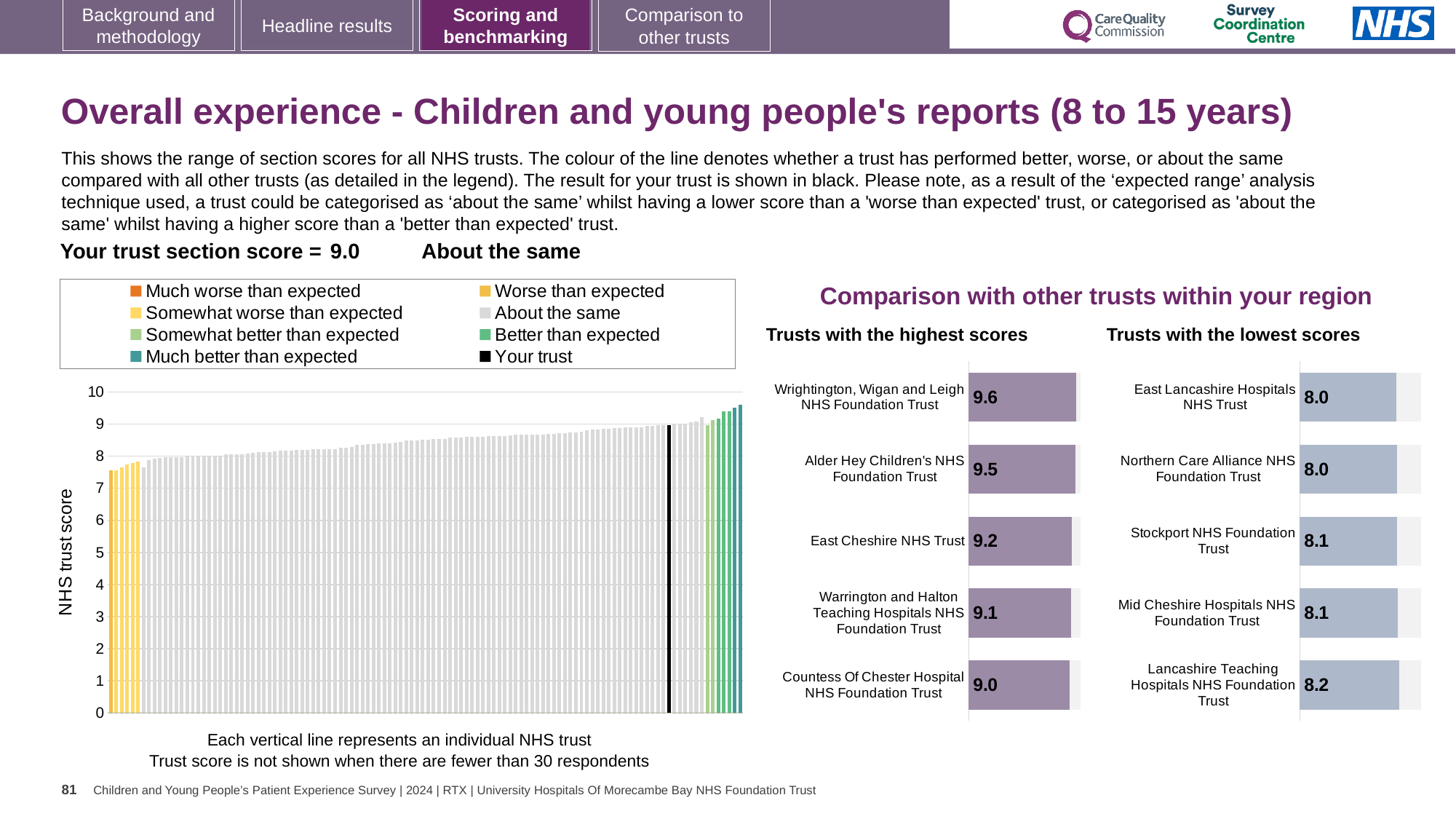
In the 'Trusts with the lowest scores' chart, what is the difference between the score for Lancashire Teaching Hospitals NHS Foundation Trust and the score for East Lancashire Hospitals NHS Trust? 0.2 In the 'Trusts with the lowest scores' chart, which has the larger score: Stockport NHS Foundation Trust or Northern Care Alliance NHS Foundation Trust? Stockport NHS Foundation Trust In the 'Trusts with the highest scores' chart, which trust has the lowest score? Countess Of Chester Hospital NHS Foundation Trust What kind of chart is the main chart on the left showing all NHS trusts? Bar chart How many trusts are listed in the 'Trusts with the highest scores' chart? 5 In the main chart on the left, is the value for the lowest-scoring trust (the leftmost bar) greater or less than 8? less In the 'Trusts with the highest scores' chart, what is the difference between the scores of Wrightington, Wigan and Leigh NHS Foundation Trust and Alder Hey Children's NHS Foundation Trust? 0.1 In the 'Trusts with the highest scores' chart, what is the score for East Cheshire NHS Trust? 9.2 In the 'Trusts with the highest scores' chart, which trust has the highest score? Wrightington, Wigan and Leigh NHS Foundation Trust In the 'Trusts with the highest scores' chart, what is the score for Wrightington, Wigan and Leigh NHS Foundation Trust? 9.6 In the 'Trusts with the lowest scores' chart, what is the score for Lancashire Teaching Hospitals NHS Foundation Trust? 8.2 How many entries does the legend of the main chart on the left list? 8